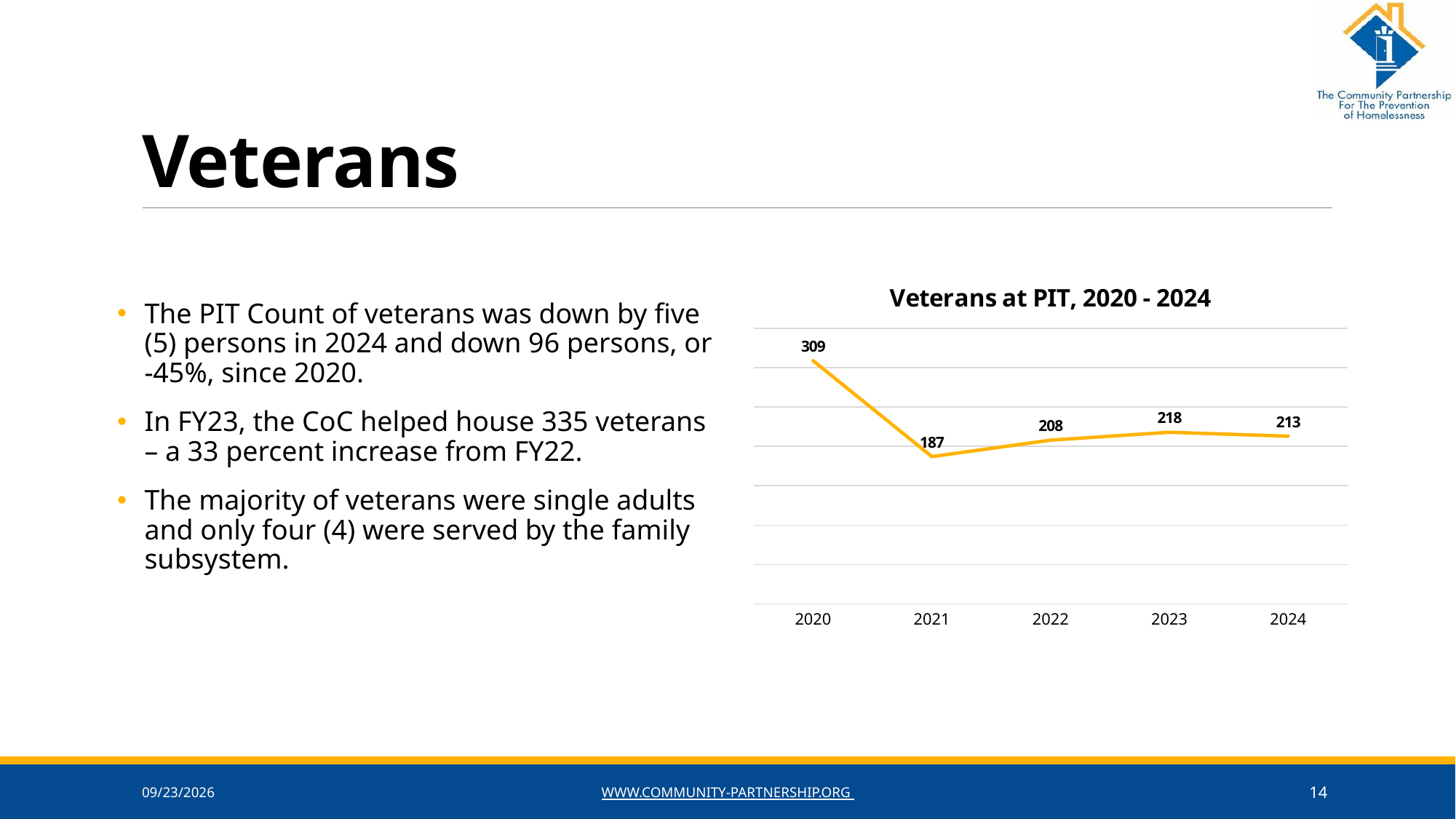
Which is larger in the Veterans at PIT chart, the value for 2022 or the value for 2021? 2022 Which year has the lowest value in the Veterans at PIT chart? 2021 What is the title of the chart on the slide? Veterans at PIT, 2020 - 2024 Which year has the highest value in the Veterans at PIT chart? 2020 What is the value for 2024 in the Veterans at PIT chart? 213 What is the value for 2023 in the Veterans at PIT chart? 218 What is the difference between the 2023 and 2022 values in the Veterans at PIT chart? 10 What kind of chart is the Veterans at PIT chart? Line chart What is the value for 2020 in the Veterans at PIT chart? 309 How many years are plotted in the Veterans at PIT chart? 5 What is the value for 2021 in the Veterans at PIT chart? 187 What is the difference between the 2020 and 2024 values in the Veterans at PIT chart? 96